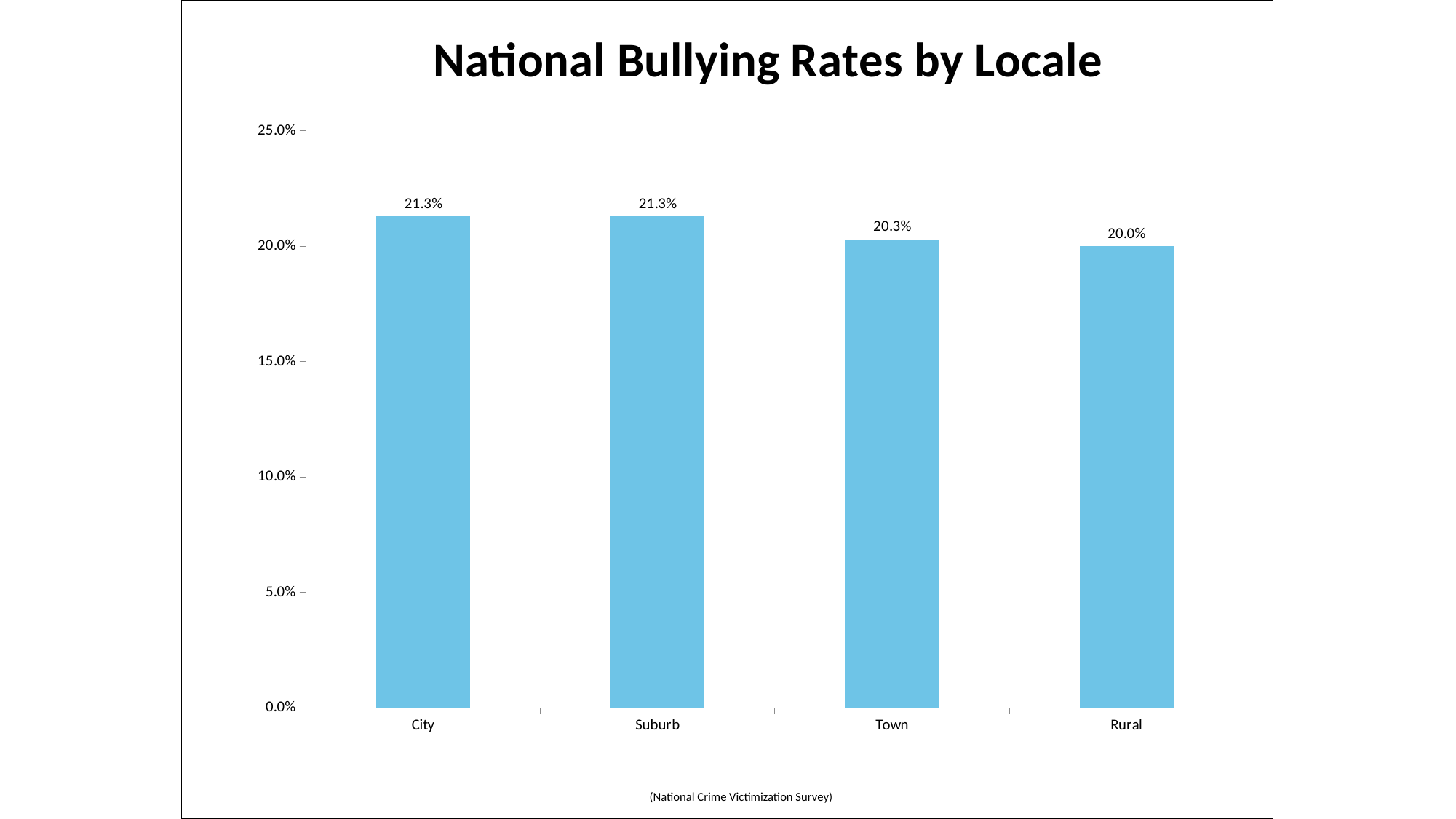
What kind of chart is shown on the slide? Bar chart What is the bullying rate for City? 21.3% Which locale has the lowest bullying rate? Rural What is the bullying rate for Town? 20.3% What is the title of the chart? National Bullying Rates by Locale What is the difference between the bullying rates for Suburb and Town? 1.0% How many locales are shown in the chart? 4 What is the difference between the bullying rates for City and Rural? 1.3% Which has a higher bullying rate, Suburb or Town? Suburb What is the bullying rate for Rural? 20.0% Is the value for Town greater or less than 15.0%? greater What is the bullying rate for Suburb? 21.3%